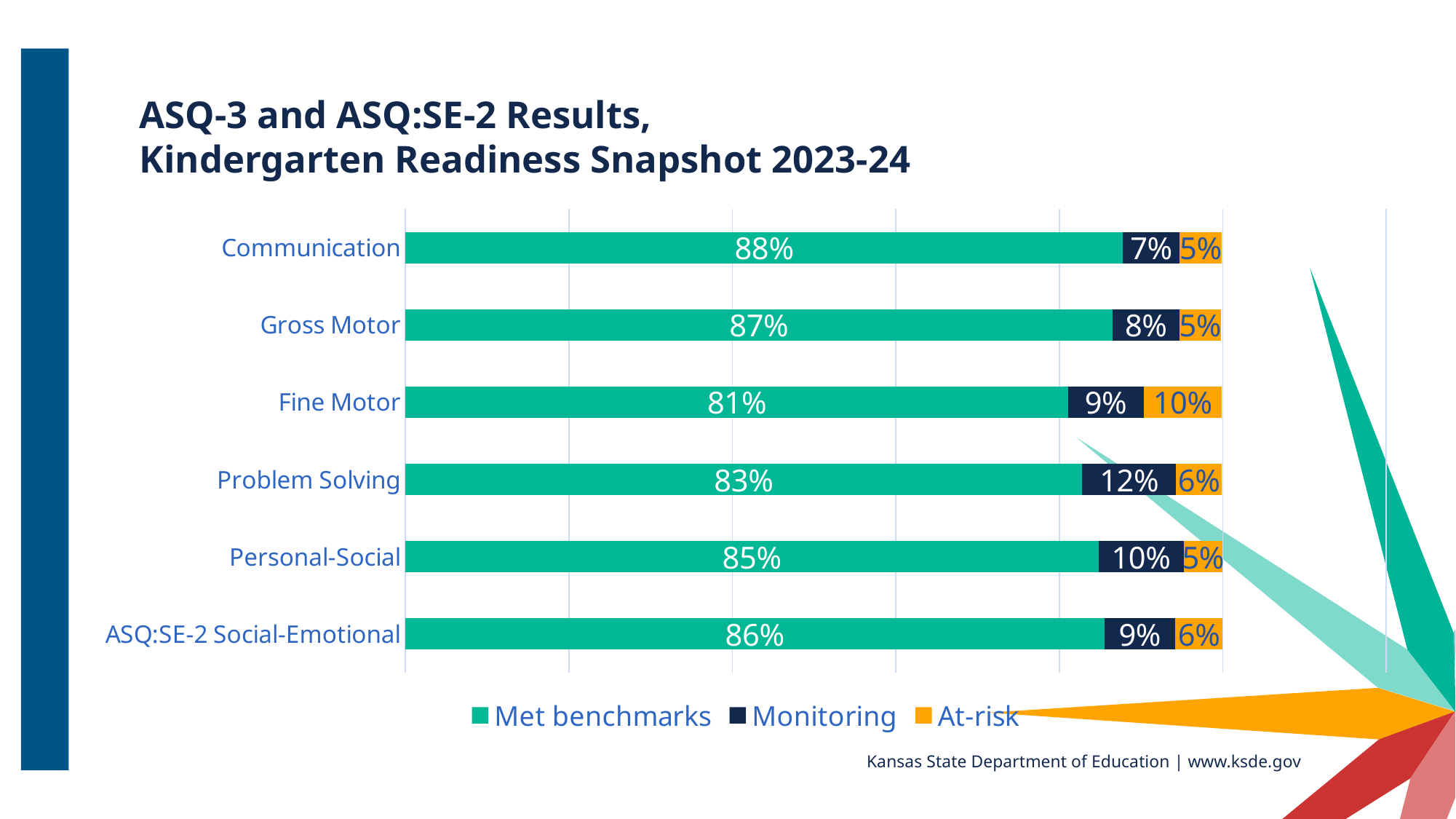
Which is larger, the Met benchmarks value for Gross Motor or for Personal-Social? Gross Motor How many categories are shown on the chart? 6 What is the Monitoring value for Problem Solving? 12% Which category has the highest Monitoring percentage? Problem Solving What kind of chart is shown on the slide? Stacked bar chart What is the difference between the Met benchmarks values for Communication and Fine Motor? 7% What is the At-risk value for Fine Motor? 10% What is the total of the stacked bar for Fine Motor? 100% What percentage of children met benchmarks in Communication? 88% Which category has the highest Met benchmarks percentage? Communication Which category has the lowest Met benchmarks percentage? Fine Motor How many series does the legend list? 3